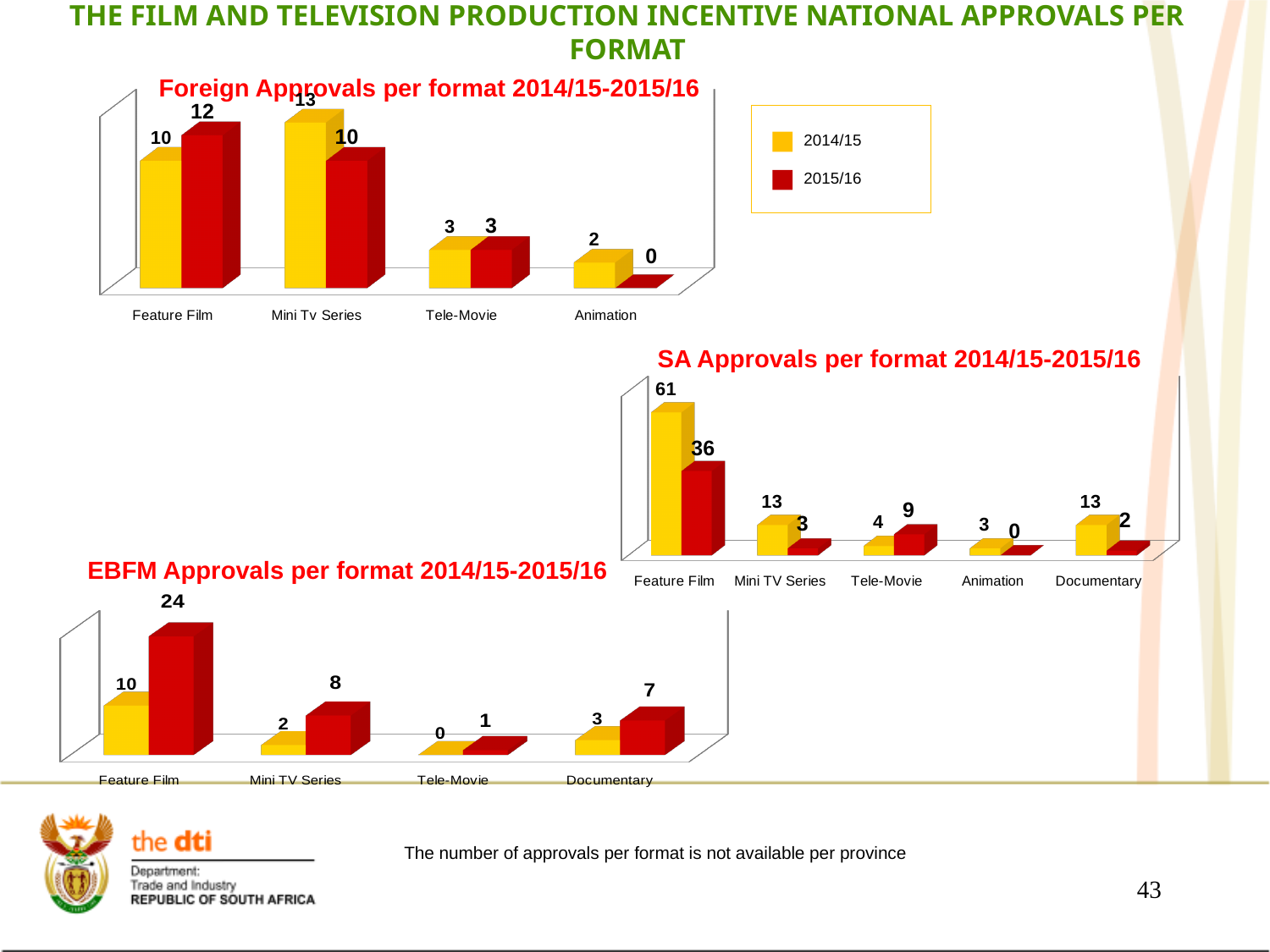
How many series does the legend list for the charts on this slide? 2 In the 'SA Approvals per format 2014/15-2015/16' chart, how many formats are shown on the x axis? 5 What type of chart is the 'SA Approvals per format 2014/15-2015/16' chart? Bar chart In the 'Foreign Approvals per format 2014/15-2015/16' chart, what is the value for Mini Tv Series in 2014/15? 13 In the 'SA Approvals per format 2014/15-2015/16' chart, which format has the highest value in 2014/15? Feature Film In the 'EBFM Approvals per format 2014/15-2015/16' chart, which is larger for Documentary: the 2014/15 value or the 2015/16 value? 2015/16 In the 'EBFM Approvals per format 2014/15-2015/16' chart, which format has the lowest value in 2014/15? Tele-Movie In the 'Foreign Approvals per format 2014/15-2015/16' chart, what is the difference between the 2015/16 and 2014/15 values for Feature Film? 2 In the 'SA Approvals per format 2014/15-2015/16' chart, what is the difference between the 2014/15 and 2015/16 values for Feature Film? 25 In the 'EBFM Approvals per format 2014/15-2015/16' chart, what is the value for Feature Film in 2015/16? 24 In the 'Foreign Approvals per format 2014/15-2015/16' chart, what is the value for Animation in 2015/16? 0 In the 'SA Approvals per format 2014/15-2015/16' chart, what is the value for Tele-Movie in 2015/16? 9